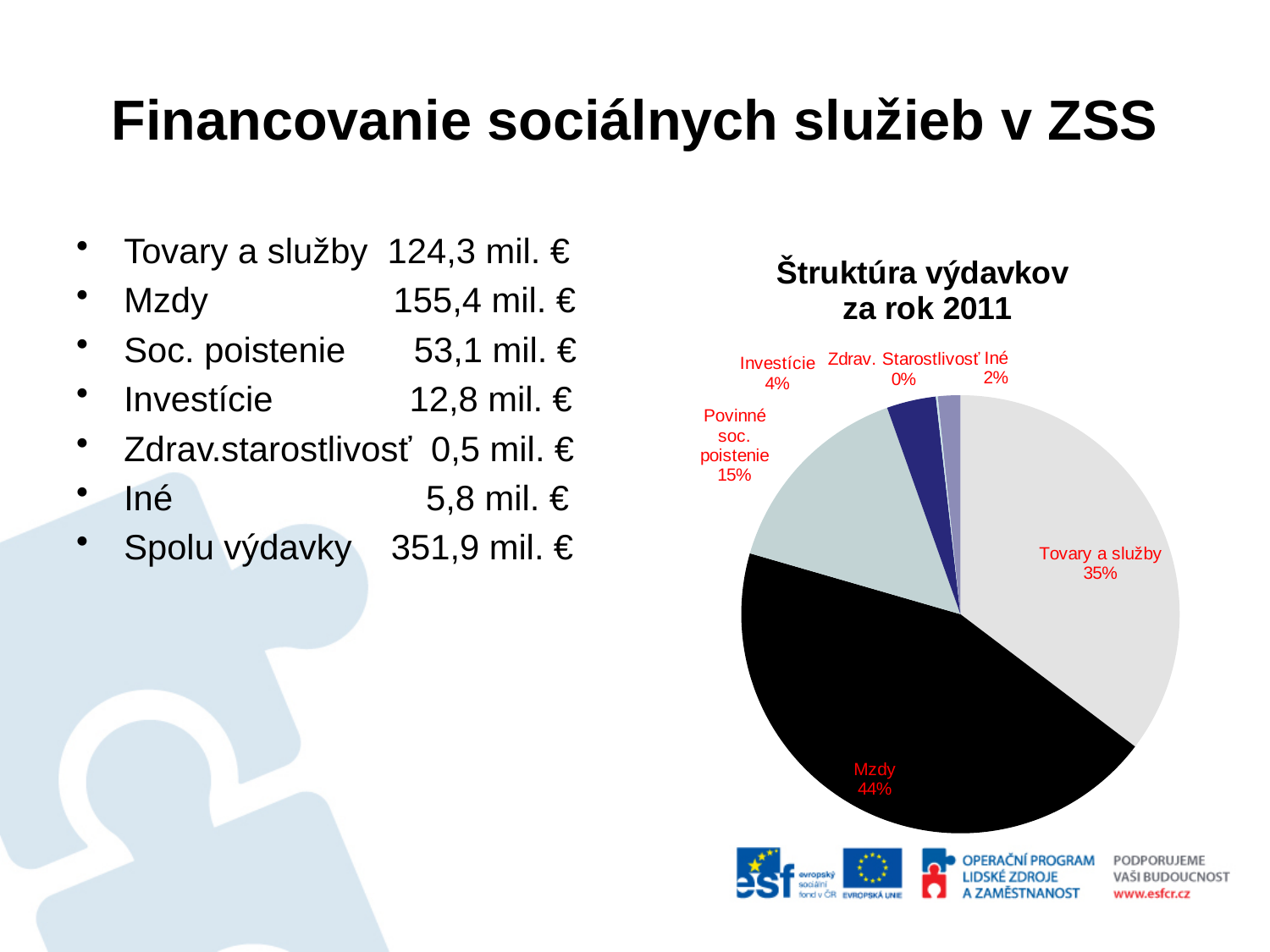
What share of the pie does Mzdy represent? 44% What share of the pie does Iné represent? 2% Which category has the smallest slice of the pie? Zdrav. Starostlivosť What share of the pie does Zdrav. Starostlivosť represent? 0% What type of chart is shown on the slide? pie chart What is the difference in percentage points between the Mzdy slice and the Tovary a služby slice? 9 percentage points How many categories are shown in the pie chart? 6 What is the title of the chart? Štruktúra výdavkov za rok 2011 Which category has the largest slice of the pie? Mzdy